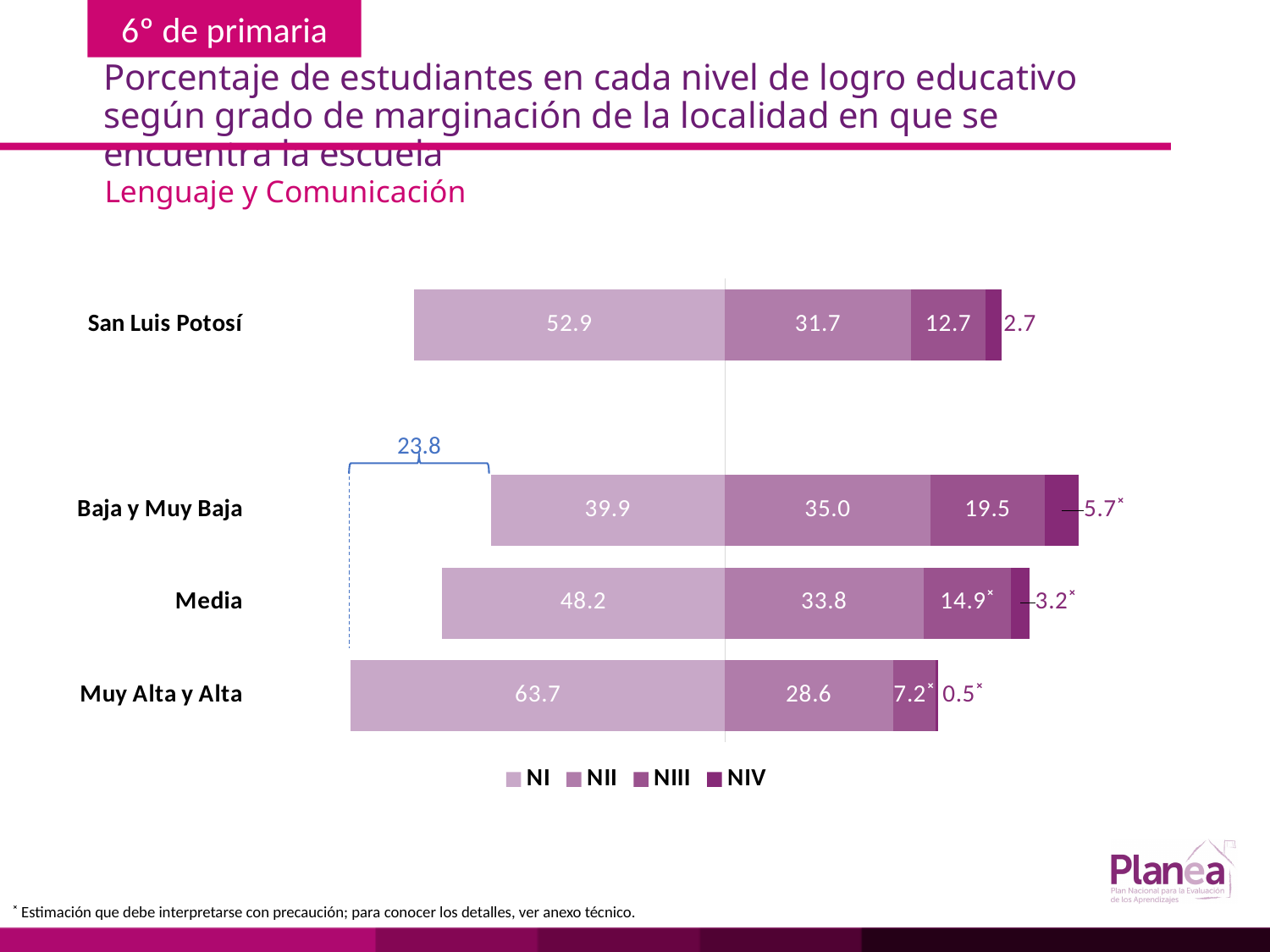
Which category has the highest NI value? Muy Alta y Alta Which has a larger NIII value, Baja y Muy Baja or Media? Baja y Muy Baja What is the NIII value for Muy Alta y Alta? 7.2 What are the series names listed in the legend? NI, NII, NIII, NIV Which category has the lowest NI value? Baja y Muy Baja What kind of chart is shown on the slide? Stacked bar chart What is the NI value for San Luis Potosí? 52.9 How many series does the legend list? 4 What is the NIV value for Baja y Muy Baja? 5.7 What is the NII value for the Media category? 33.8 How many categories (bars) are shown in the chart? 4 What is the difference between the NI values of Muy Alta y Alta and Baja y Muy Baja? 23.8